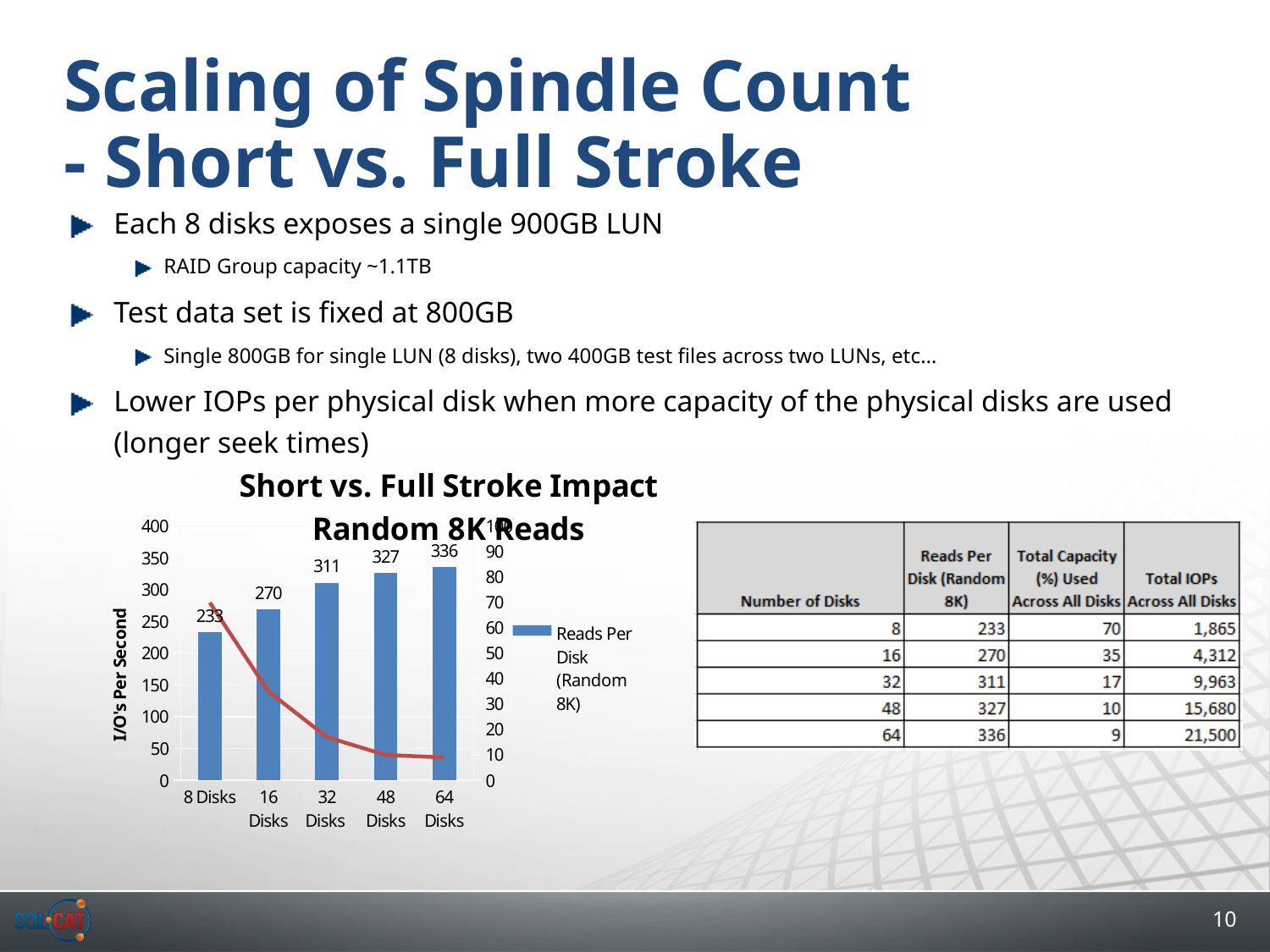
Which has a higher Reads Per Disk value, 16 Disks or 32 Disks? 32 Disks What is the difference in Reads Per Disk between 48 Disks and 16 Disks? 57 What is the Reads Per Disk (Random 8K) value for 64 Disks? 336 What kind of chart is used to show Reads Per Disk (Random 8K)? Bar chart What is the Reads Per Disk (Random 8K) value for 8 Disks? 233 How many disk-count categories are shown on the x axis of the chart? 5 What is the Reads Per Disk (Random 8K) value for 32 Disks? 311 Which disk count has the highest Reads Per Disk value? 64 Disks Do the Reads Per Disk bars rise or fall as the number of disks increases? Rise Which disk count has the lowest Reads Per Disk value? 8 Disks What is the label of the vertical axis on the left of the chart? I/O's Per Second What is the difference in Reads Per Disk between 64 Disks and 8 Disks? 103